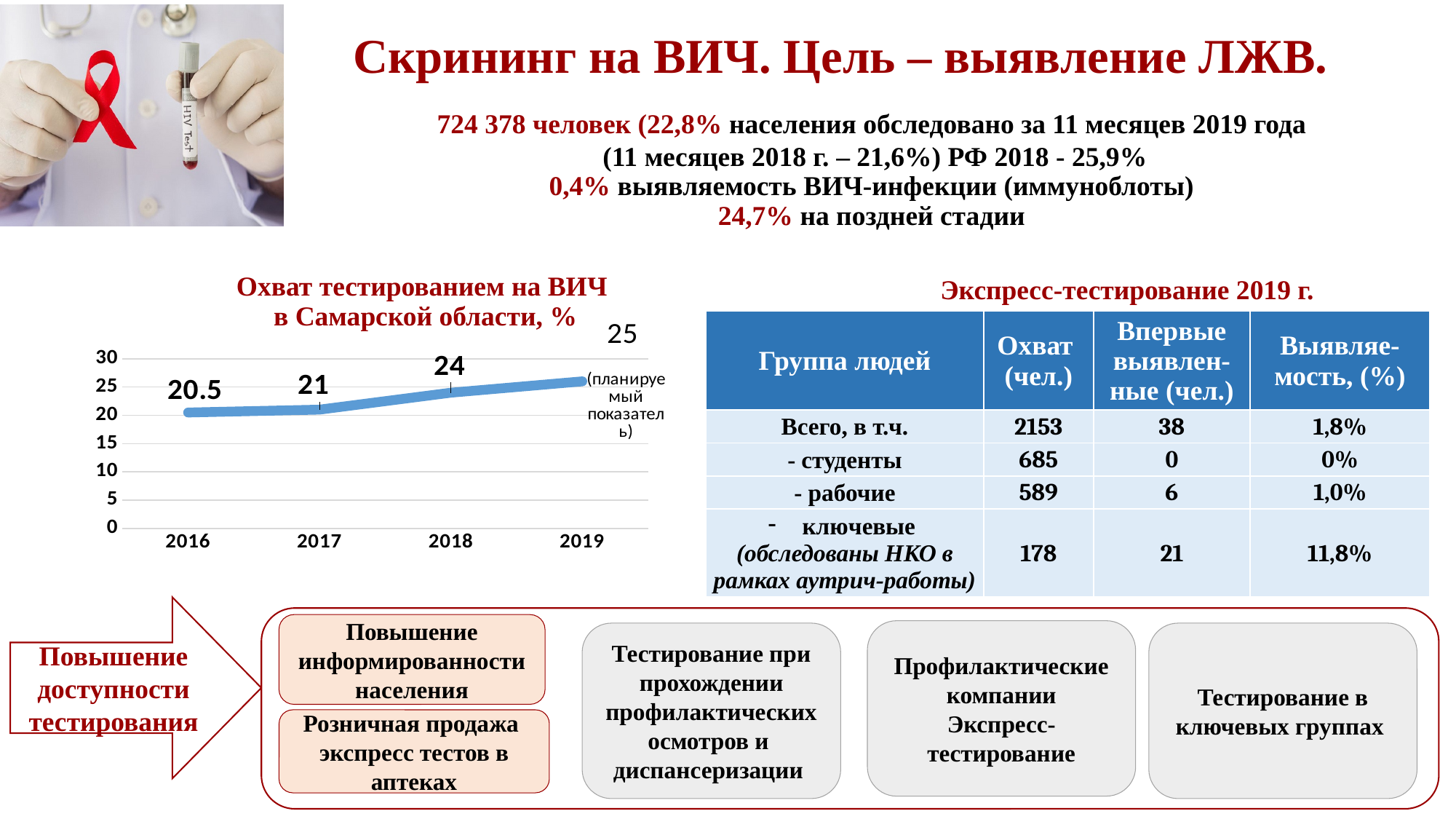
Do the values in the line chart rise or fall from 2016 to 2019? rise Which year has the lowest value in the line chart? 2016 What kind of chart is used to show HIV testing coverage in the Samara region? line chart By how much does the value for 2018 exceed the value for 2016 in the line chart? 3.5 What is the planned value shown for 2019 in the line chart? 25 How many years are plotted on the x axis of the line chart? 4 Which is larger in the line chart, the value for 2017 or the value for 2018? 2018 Is the value for 2017 in the line chart greater or less than 25? less What value does the chart show for 2018? 24 Which year has the highest value in the line chart? 2019 What is the HIV testing coverage value for 2016 in the chart 'Охват тестированием на ВИЧ в Самарской области, %'? 20.5